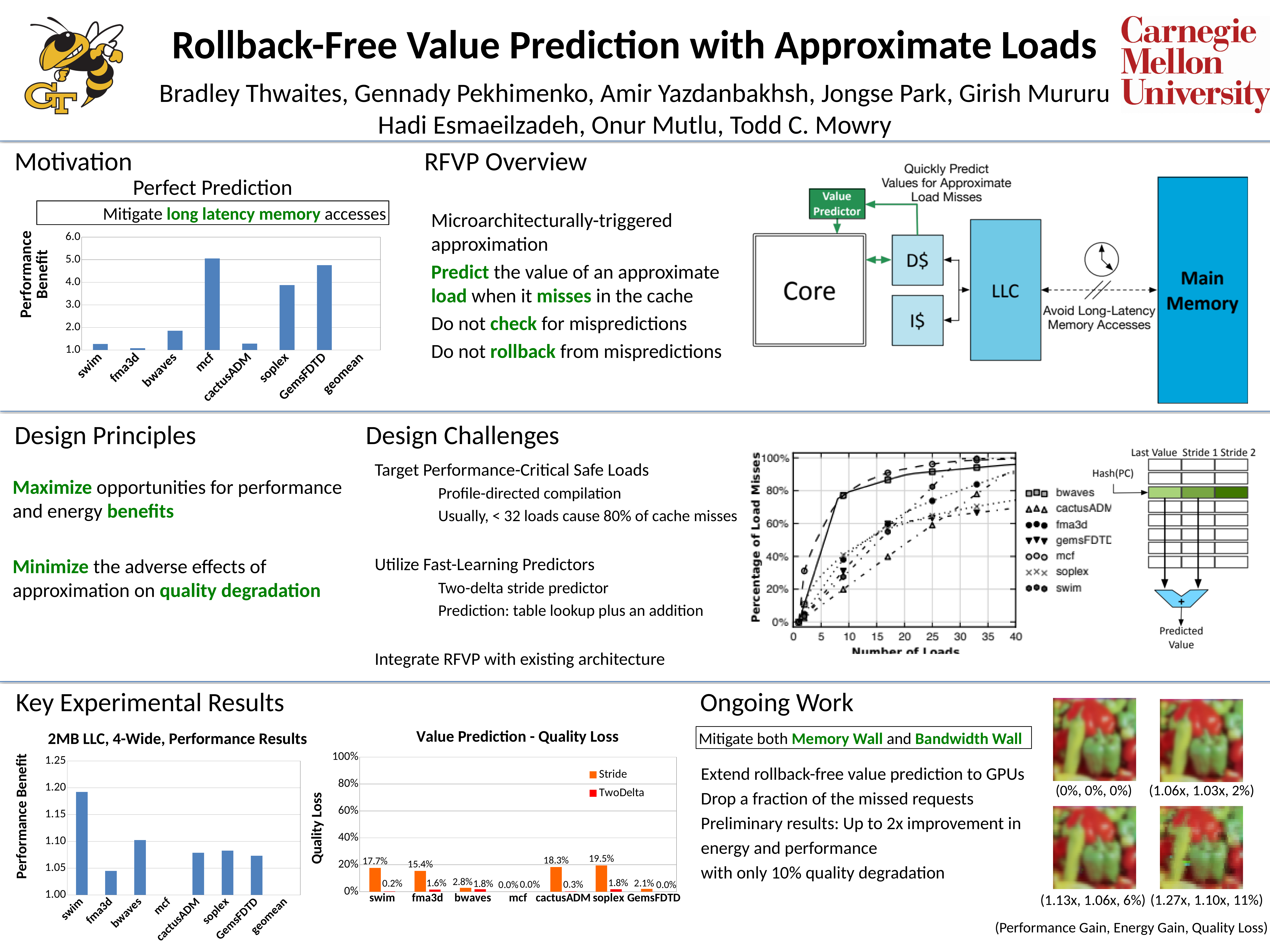
In the "Value Prediction - Quality Loss" chart, what is the difference between the Stride and TwoDelta quality loss for cactusADM? 18.0% In the "Value Prediction - Quality Loss" chart, what is the Stride quality loss for soplex? 19.5% In the "Value Prediction - Quality Loss" chart, how many benchmarks are shown on the x axis? 7 In the "2MB LLC, 4-Wide, Performance Results" chart, which benchmark has the highest performance benefit? swim In the "Value Prediction - Quality Loss" chart, which benchmark has the highest Stride quality loss? soplex In the "Value Prediction - Quality Loss" chart, what is the TwoDelta quality loss for fma3d? 1.6% In the "Value Prediction - Quality Loss" chart, how many series does the legend list? 2 In the "Perfect Prediction" chart, which benchmark has the highest performance benefit? mcf In the "Perfect Prediction" chart, is the performance benefit for soplex greater or less than 3.0? greater In the "Percentage of Load Misses" line chart, how many benchmarks does the legend list? 7 In the "Value Prediction - Quality Loss" chart, is the Stride quality loss for swim larger or smaller than the Stride quality loss for fma3d? larger